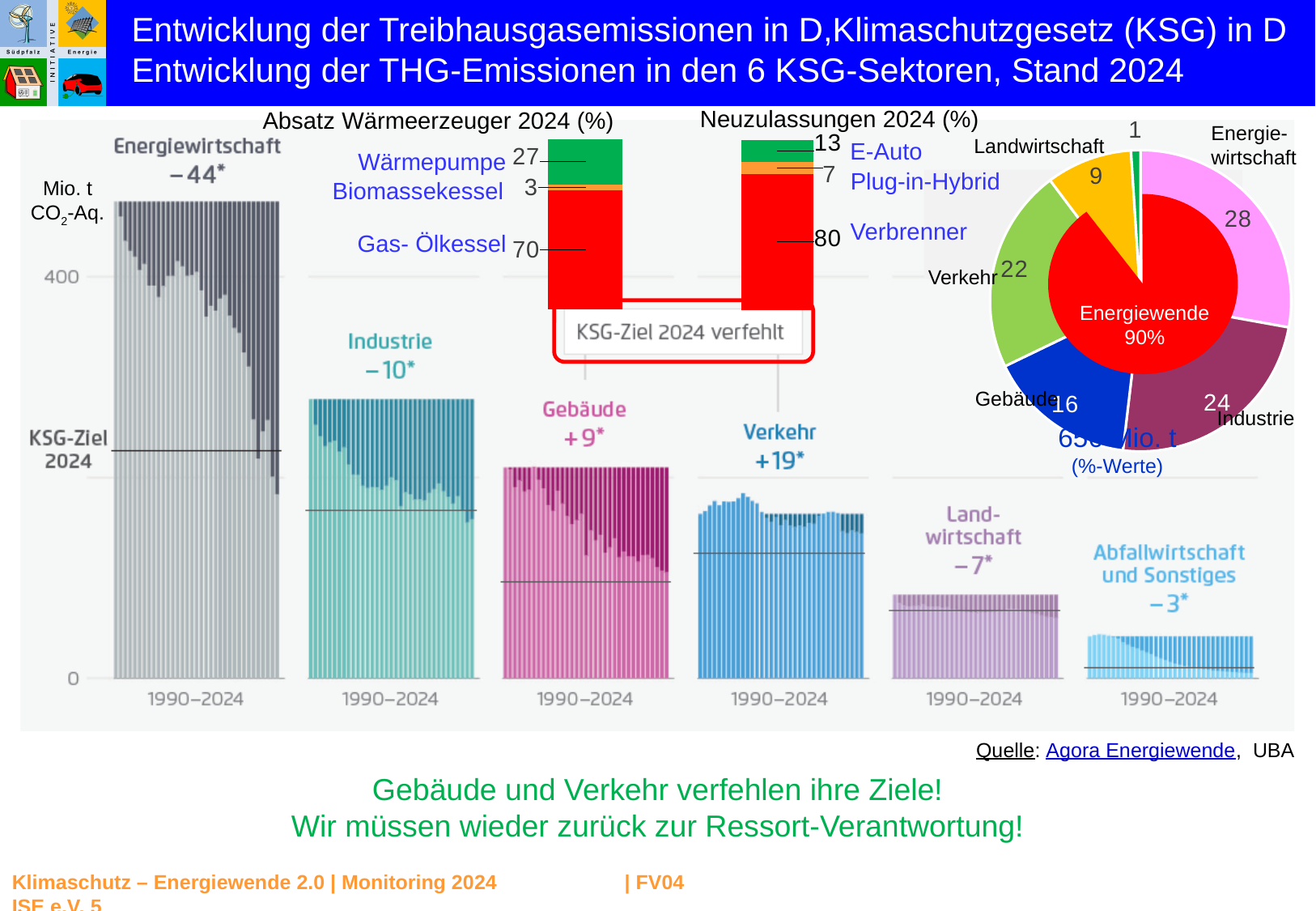
In the pie chart on the right, what is the percentage value for Energiewirtschaft? 28 In the 'Neuzulassungen 2024 (%)' stacked bar, what is the value for Verbrenner? 80 In the 'Absatz Wärmeerzeuger 2024 (%)' stacked bar, what is the value for Wärmepumpe? 27 In the pie chart on the right, which is larger, Gebäude or Verkehr? Verkehr In the pie chart on the right, which labelled sector has the largest share? Energiewirtschaft In the large emissions chart (1990–2024), how many sectors are shown? 6 In the pie chart on the right, what is the difference between the Energiewirtschaft and Industrie values? 4 In the 'Absatz Wärmeerzeuger 2024 (%)' stacked bar, which segment is the largest? Gas- Ölkessel In the 'Neuzulassungen 2024 (%)' stacked bar, what is the difference between the E-Auto and Plug-in-Hybrid values? 6 In the 'Absatz Wärmeerzeuger 2024 (%)' stacked bar, what is the value for Biomassekessel? 3 In the large emissions chart (1990–2024), what change is printed for the Verkehr sector? +19* In the large emissions chart (1990–2024), do the Energiewirtschaft values rise or fall from 1990 to 2024? fall